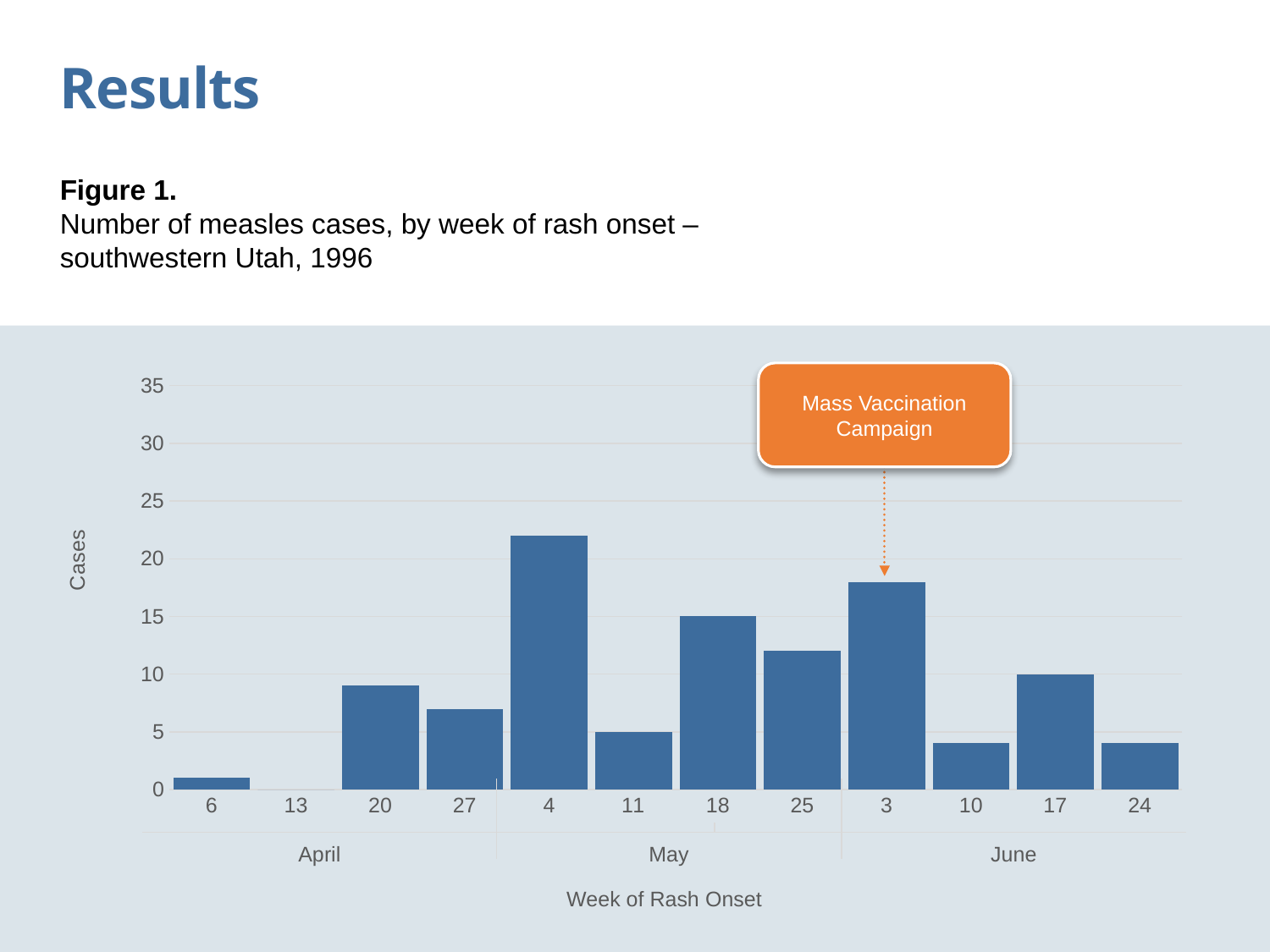
Do the cases rise or fall from the week of May 4 to the week of May 11? fall What event does the orange callout above the June 3 bar label? Mass Vaccination Campaign Which week of rash onset has the lowest number of cases? April 13 What kind of chart is shown on the slide? bar chart Is the number of cases for the week of June 3 greater or less than 20? less How many cases are shown for the week of June 17? 10 Is the number of cases for the week of May 4 greater or less than 20? greater Which week of rash onset has the highest number of cases? May 4 How many cases are shown for the week of May 18? 15 How many weeks of rash onset are plotted on the x axis? 12 Which week has more cases, May 4 or June 3? May 4 Is the number of cases for the week of April 20 greater or less than 10? less